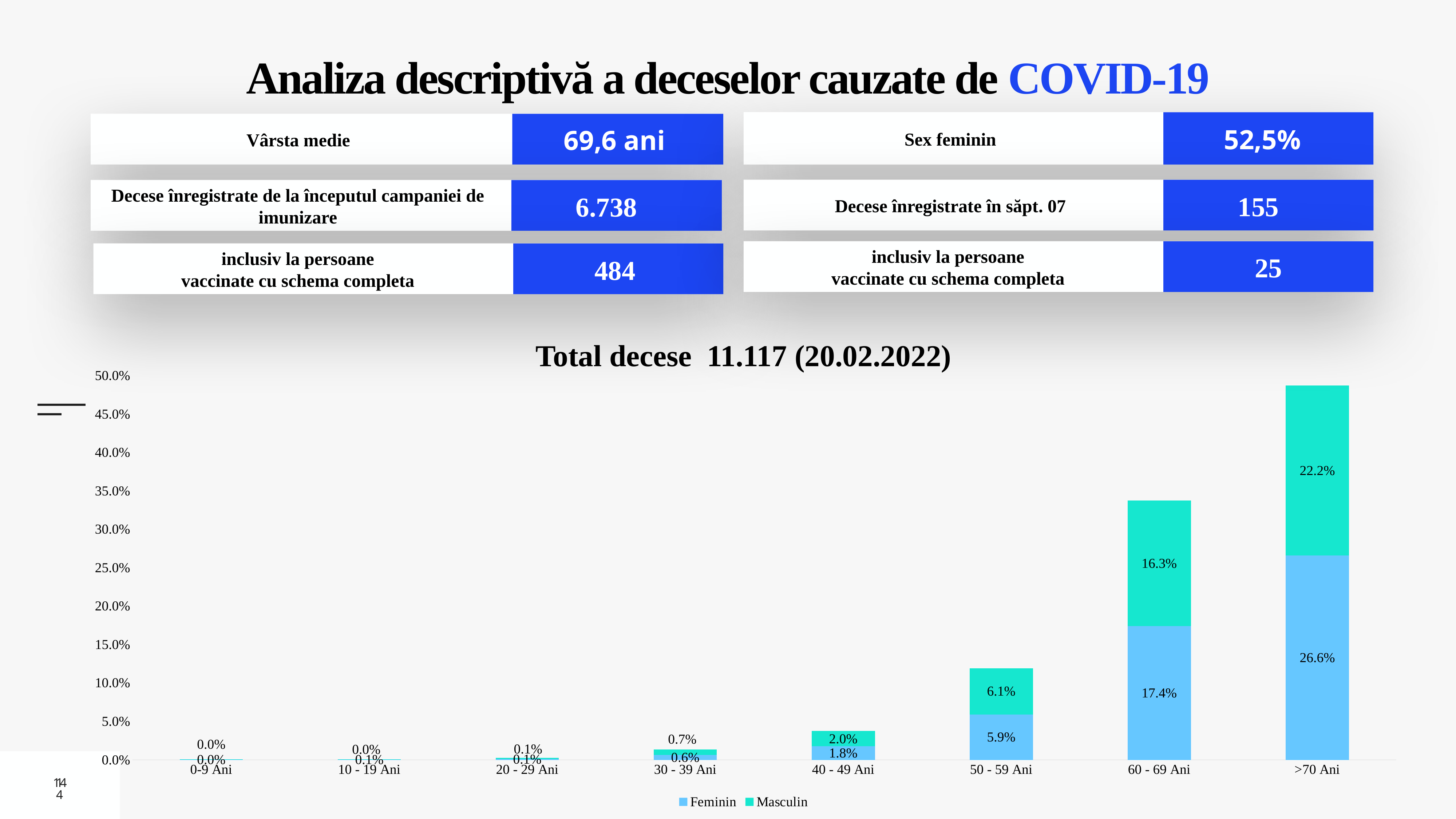
What is the Masculin value for the 40 - 49 Ani age group? 2.0% How many age groups are shown on the x axis of the chart? 8 Which age group has the highest Masculin value? >70 Ani What is the total of the stacked bar for the 60 - 69 Ani age group? 33.7% What is the Masculin value for the 60 - 69 Ani age group? 16.3% What is the total of the stacked bar for the 50 - 59 Ani age group? 12.0% What is the Feminin value for the 50 - 59 Ani age group? 5.9% Which is larger for the 60 - 69 Ani age group, the Feminin value or the Masculin value? Feminin What is the difference between the Feminin and Masculin values for the >70 Ani age group? 4.4% How many series does the chart legend list? 2 What is the Feminin value for the >70 Ani age group? 26.6% What kind of chart is shown on the slide? Stacked bar chart